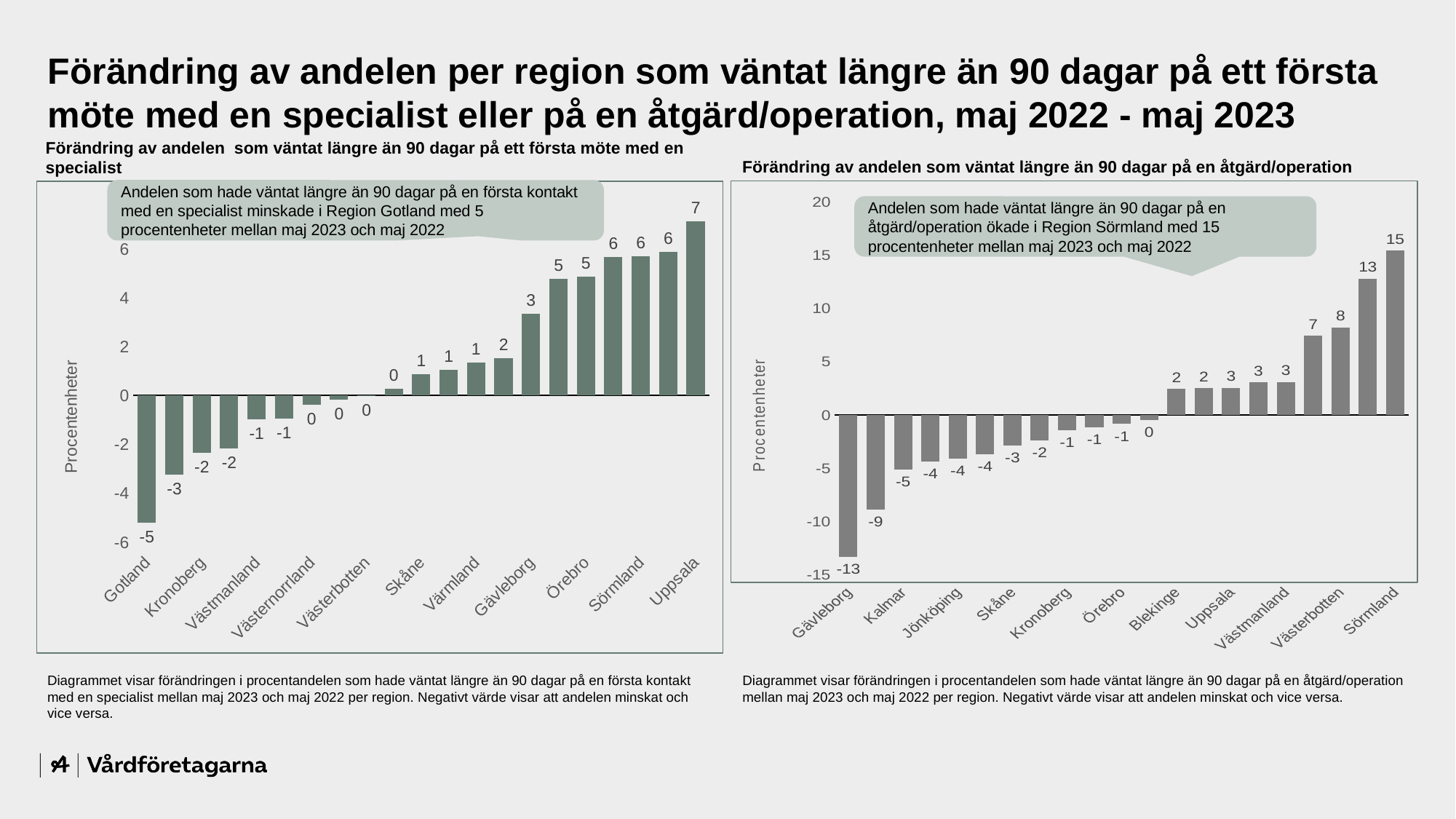
In the left chart (first meeting with a specialist), which region has the highest value? Uppsala In the right chart (åtgärd/operation), what is the value for Sörmland? 15 In the left chart (first meeting with a specialist), what is the value for Gotland? -5 In the right chart (åtgärd/operation), do the values rise or fall from left to right along the x axis? rise In the right chart (åtgärd/operation), what is the value for Gävleborg? -13 What kind of chart is the right chart (åtgärd/operation)? bar chart In the left chart (first meeting with a specialist), what is the value for Uppsala? 7 In the left chart (first meeting with a specialist), which region has the lowest value? Gotland In the left chart (first meeting with a specialist), what is the difference between the values for Uppsala and Gotland? 12 In the left chart (first meeting with a specialist), how many bars are plotted? 21 In the right chart (åtgärd/operation), which region has the lowest value? Gävleborg In the right chart (åtgärd/operation), what is the difference between the values for Sörmland and Gävleborg? 28